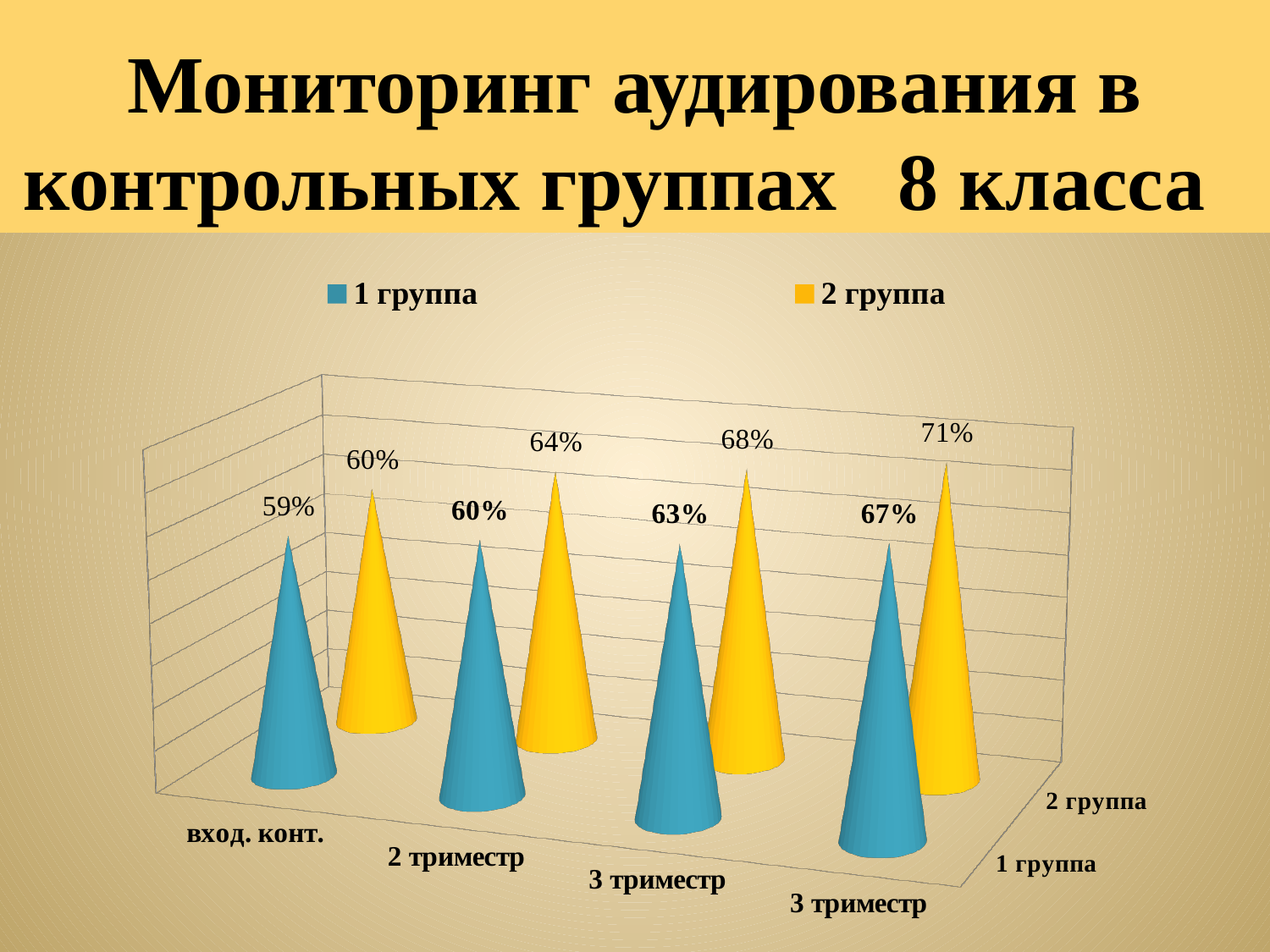
What is the value for 2 группа at вход. конт.? 60% Do the values for 1 группа rise or fall from the first category to the last? rise What is the highest value shown for 2 группа? 71% What is the difference between 2 группа and 1 группа at 2 триместр? 4% How many series does the legend list? 2 What are the two series named in the legend? 1 группа and 2 группа What is the value for 2 группа at 2 триместр? 64% What is the value for 1 группа at вход. конт.? 59% How many categories are shown along the x axis? 4 What is the value for 1 группа at 2 триместр? 60% What kind of chart is shown on the slide? bar chart What is the lowest value shown for 1 группа? 59%